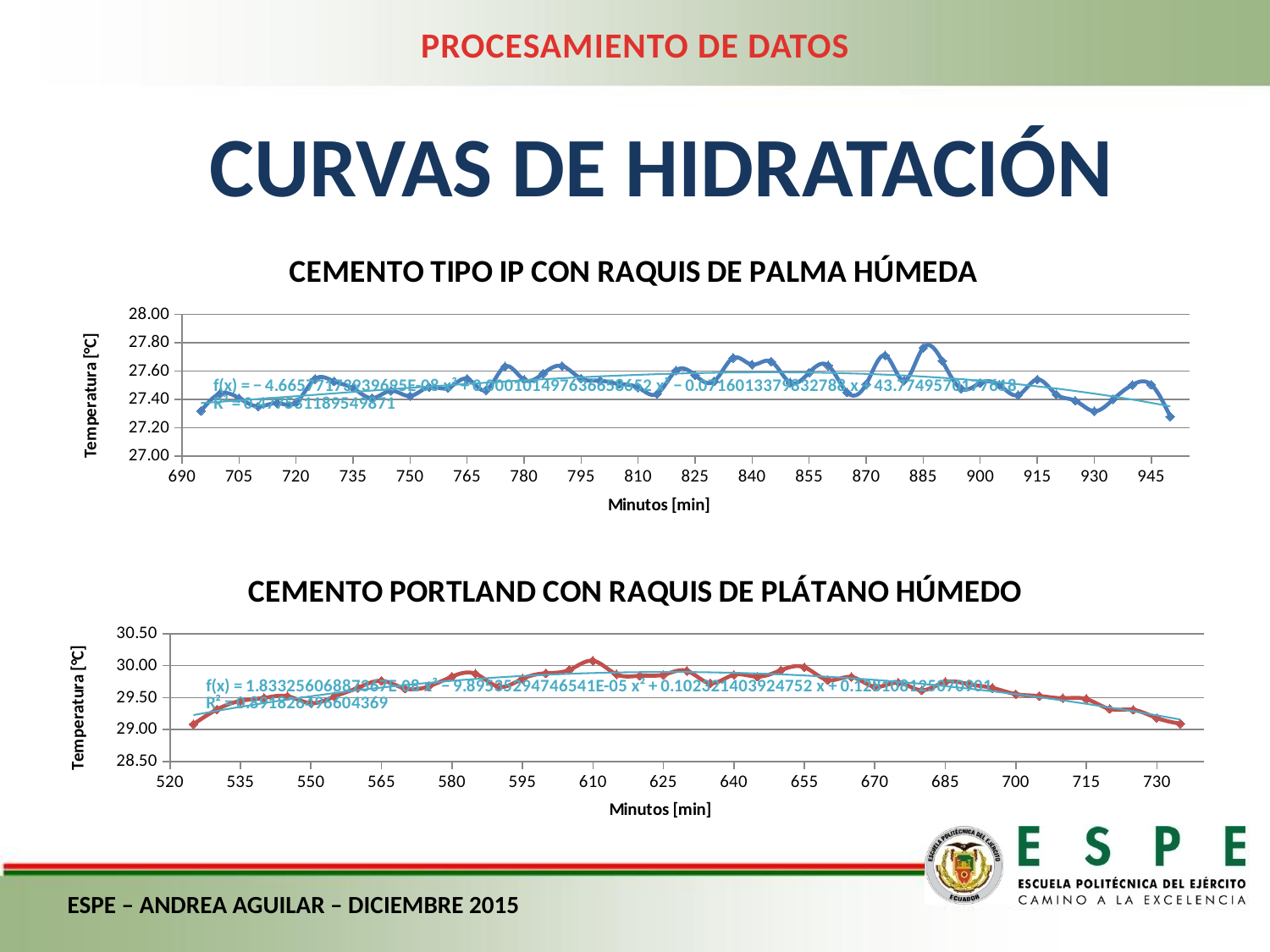
What kind of chart is the bottom chart, 'CEMENTO PORTLAND CON RAQUIS DE PLÁTANO HÚMEDO'? Line chart In the bottom chart 'CEMENTO PORTLAND CON RAQUIS DE PLÁTANO HÚMEDO', do the values rise or fall between 655 and 730 minutes? fall In the top chart 'CEMENTO TIPO IP CON RAQUIS DE PALMA HÚMEDA', is the first plotted value (near 695 minutes) greater or less than 27.40? less What is the x-axis title of the top chart 'CEMENTO TIPO IP CON RAQUIS DE PALMA HÚMEDA'? Minutos [min] In the bottom chart 'CEMENTO PORTLAND CON RAQUIS DE PLÁTANO HÚMEDO', is the value at 610 minutes greater or less than 29.50? greater In the top chart 'CEMENTO TIPO IP CON RAQUIS DE PALMA HÚMEDA', near which x-axis tick does the highest temperature occur? 885 In the bottom chart 'CEMENTO PORTLAND CON RAQUIS DE PLÁTANO HÚMEDO', is the last plotted value (near 735 minutes) greater or less than 29.50? less In the bottom chart 'CEMENTO PORTLAND CON RAQUIS DE PLÁTANO HÚMEDO', do the values rise or fall between 520 and 610 minutes? rise What kind of chart is the top chart, 'CEMENTO TIPO IP CON RAQUIS DE PALMA HÚMEDA'? Line chart In the bottom chart 'CEMENTO PORTLAND CON RAQUIS DE PLÁTANO HÚMEDO', near which x-axis tick does the highest temperature occur? 610